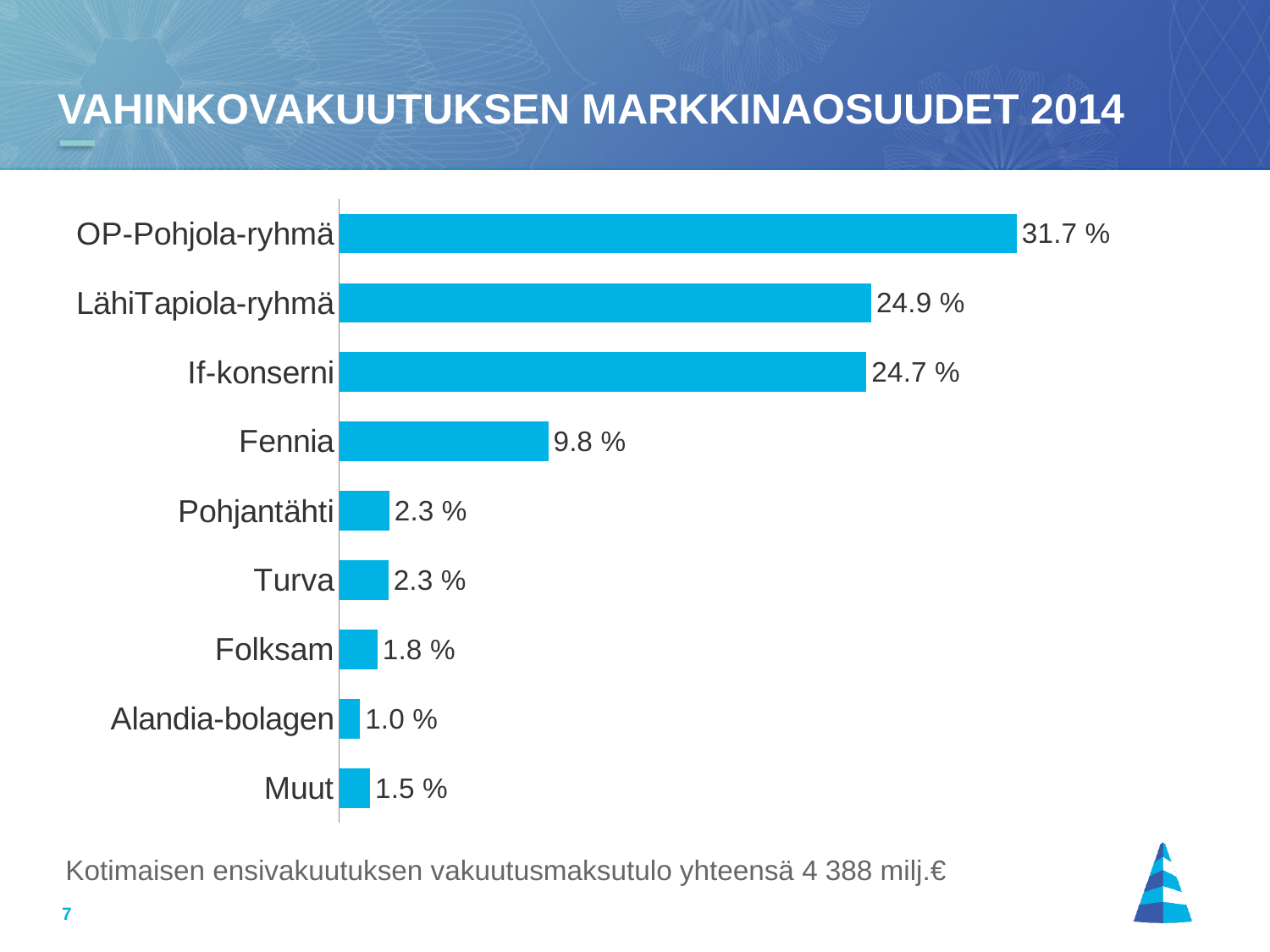
Which category has the highest market share? OP-Pohjola-ryhmä What is the market share shown for Fennia? 9.8 % What is the title of the slide? VAHINKOVAKUUTUKSEN MARKKINAOSUUDET 2014 What is the market share shown for Muut? 1.5 % How many categories are shown in the chart? 9 What kind of chart is shown on the slide? Bar chart What is the difference between the market shares of Fennia and Folksam? 8.0 % Which has a larger market share, Muut or Alandia-bolagen? Muut What is the market share shown for OP-Pohjola-ryhmä? 31.7 % Which category has the lowest market share? Alandia-bolagen What is the difference between the market shares of OP-Pohjola-ryhmä and LähiTapiola-ryhmä? 6.8 % What is the market share shown for Folksam? 1.8 %